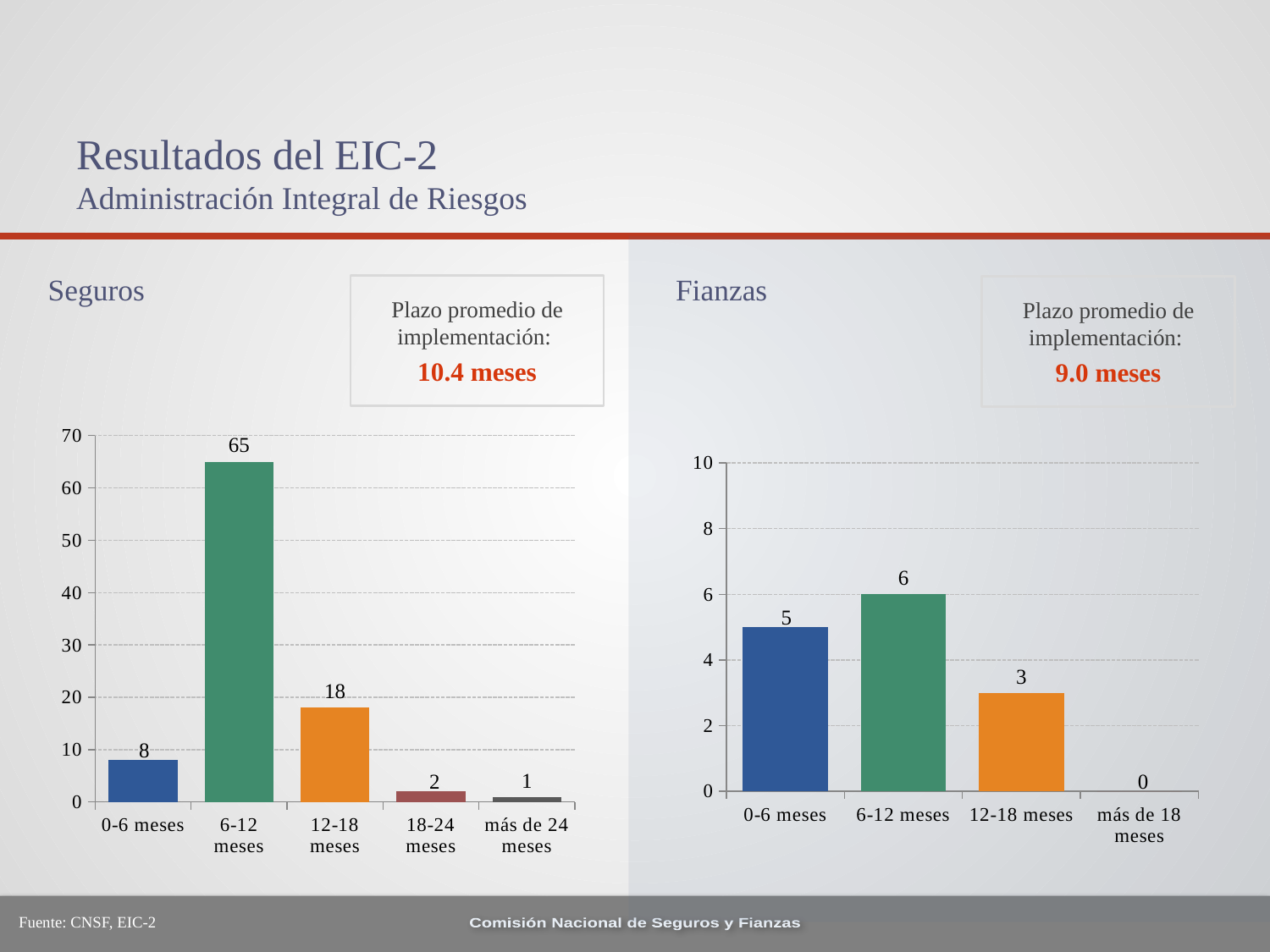
In the Fianzas chart, what is the difference between the values for 6-12 meses and 12-18 meses? 3 In the Seguros chart, which category has the highest value? 6-12 meses In the Seguros chart, what is the difference between the values for 6-12 meses and 12-18 meses? 47 In the Fianzas chart, what is the value for más de 18 meses? 0 How many categories are shown in the Fianzas chart? 4 In the Fianzas chart, what is the value for 0-6 meses? 5 In the Fianzas chart, which category has the highest value? 6-12 meses In the Seguros chart, what is the value for 18-24 meses? 2 In the Seguros chart, what is the value for 6-12 meses? 65 In the Seguros chart, which category has the lowest value? más de 24 meses In the Seguros chart, which is larger: the value for 0-6 meses or the value for 12-18 meses? 12-18 meses What type of chart is the Seguros chart? Bar chart